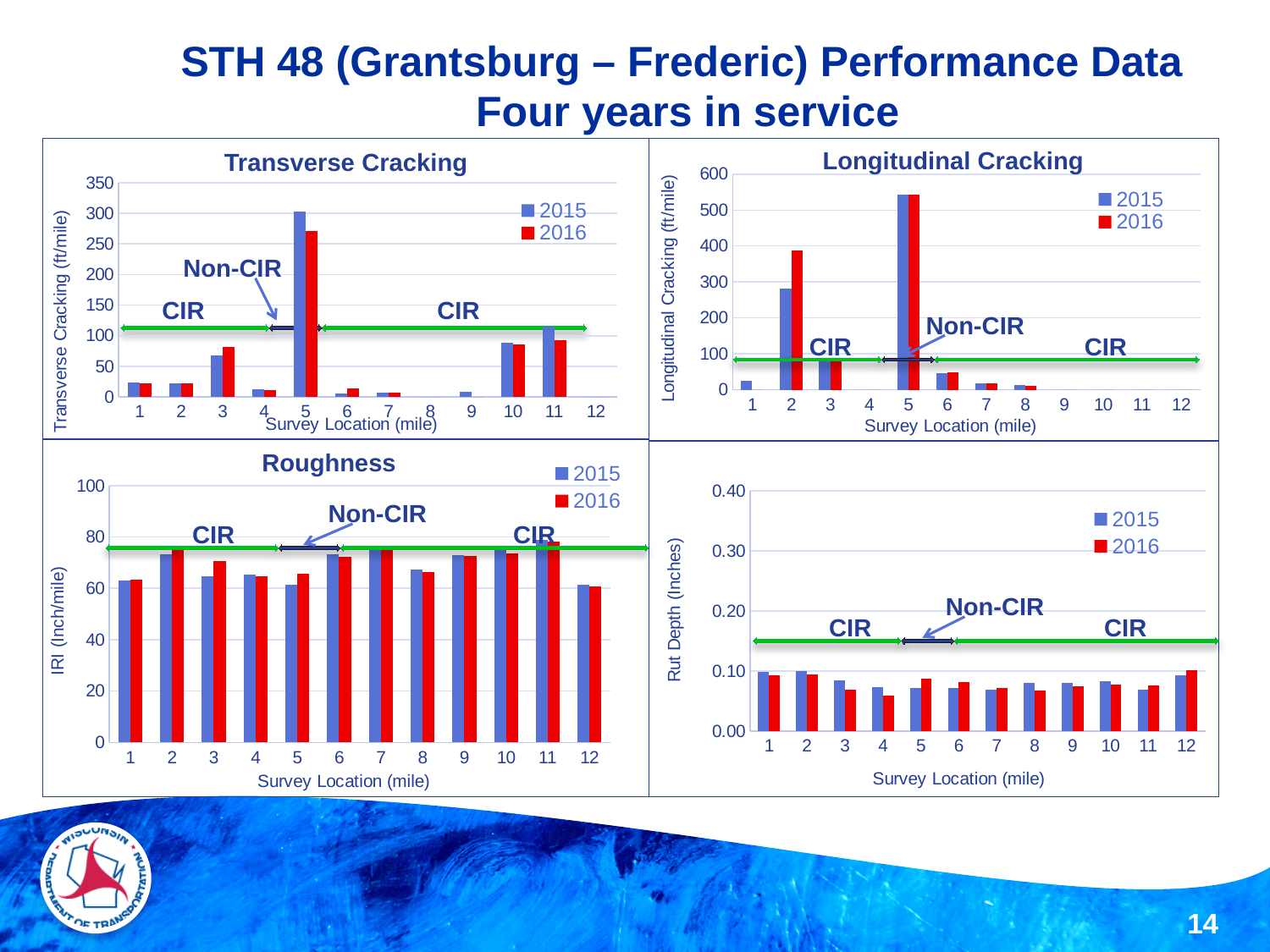
In the Roughness chart, is the 2015 value at survey location 5 greater or less than 70? less In the Longitudinal Cracking chart, is the 2016 value at survey location 2 greater or less than 300? greater In the Longitudinal Cracking chart, which survey location has the highest longitudinal cracking? 5 In the bottom-right Rut Depth chart, is the 2016 value at survey location 4 greater or less than 0.10? less In the Longitudinal Cracking chart, at survey location 2, which year has the larger value, 2015 or 2016? 2016 In the Transverse Cracking chart, which survey location has the highest transverse cracking? 5 In the Transverse Cracking chart, how many survey locations are shown on the x axis? 12 In the Roughness chart, how many series does the legend list? 2 What is the y-axis label of the Roughness chart? IRI (Inch/mile) What kind of chart is the bottom-right Rut Depth chart? bar chart